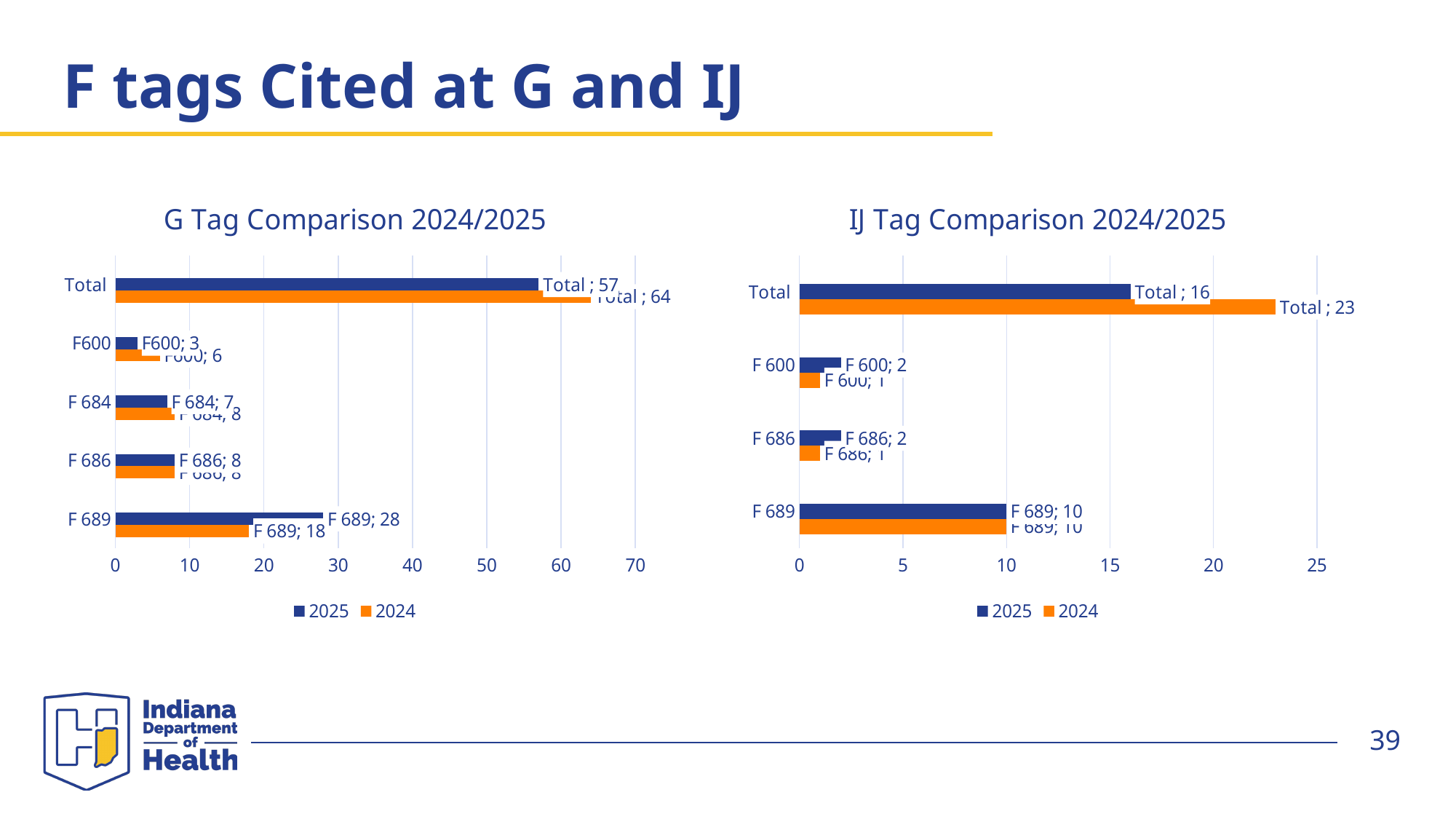
In the G Tag Comparison 2024/2025 chart, what is the 2025 value for F 689? 28 In the G Tag Comparison 2024/2025 chart, what is the Total value for 2024? 64 What type of chart is the IJ Tag Comparison 2024/2025 chart? Bar chart In the IJ Tag Comparison 2024/2025 chart, which year has the larger Total, 2025 or 2024? 2024 In the IJ Tag Comparison 2024/2025 chart, what is the 2025 value for F 689? 10 How many series does the legend of the G Tag Comparison 2024/2025 chart list? 2 In the IJ Tag Comparison 2024/2025 chart, what is the Total value for 2024? 23 How many categories are shown on the y axis of the IJ Tag Comparison 2024/2025 chart? 4 In the G Tag Comparison 2024/2025 chart, how much larger is the 2024 Total than the 2025 Total? 7 In the G Tag Comparison 2024/2025 chart, which individual F tag (excluding Total) has the highest 2025 value? F 689 In the G Tag Comparison 2024/2025 chart, what is the difference between the 2025 and 2024 values for F 689? 10 In the G Tag Comparison 2024/2025 chart, what is the Total value for 2025? 57